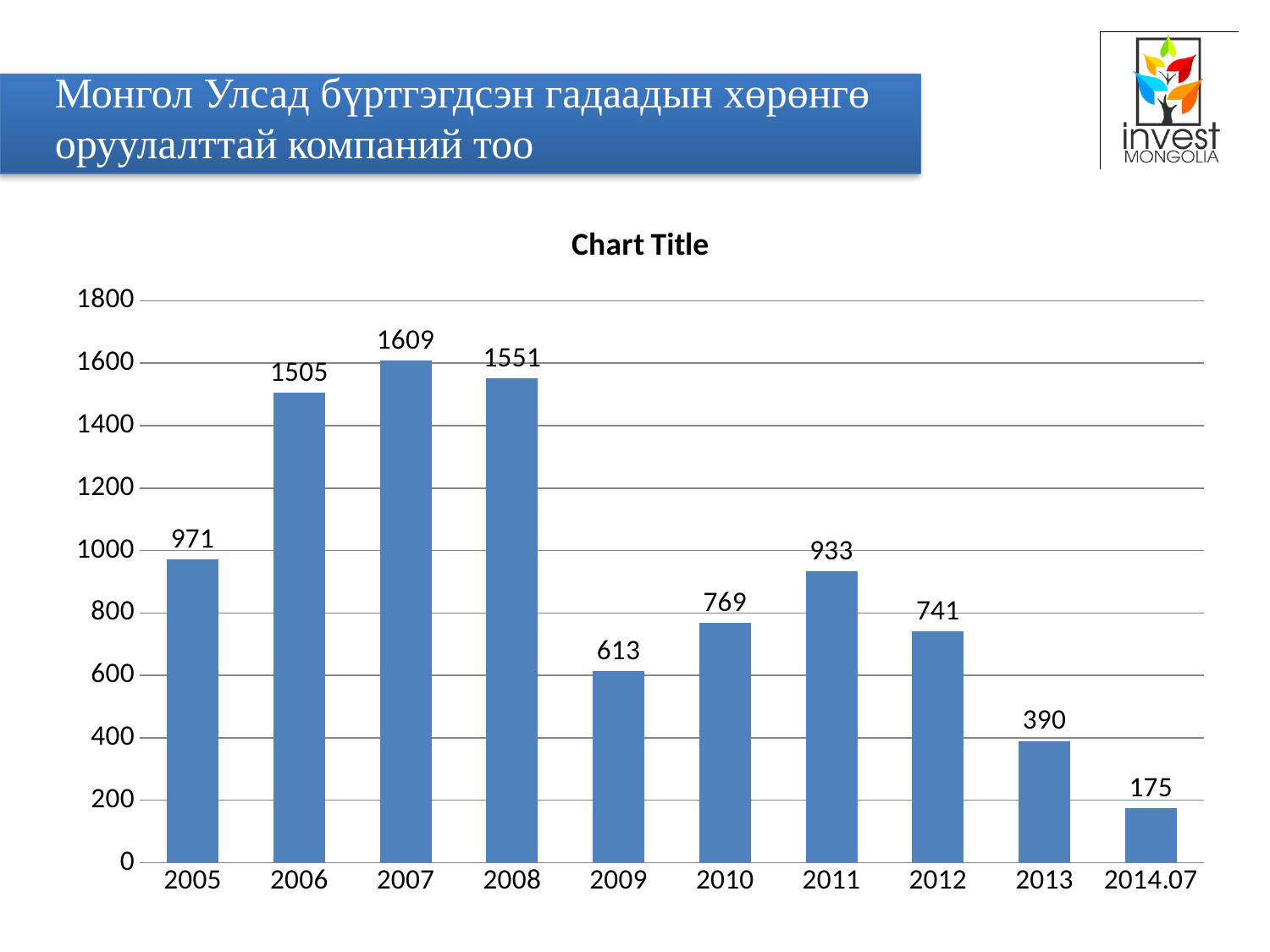
What is the value for 2011? 933 Which is larger, the value for 2010 or the value for 2012? 2010 What is the title printed above the chart? Chart Title Which year has the highest value? 2007 What kind of chart is shown on the slide? bar chart How many categories are shown on the x axis? 10 What is the difference between the values for 2008 and 2009? 938 What is the value for 2014.07? 175 Which category has the lowest value? 2014.07 Do the values rise or fall from 2011 to 2014.07? fall What is the value for 2007? 1609 Is the value for 2013 greater or less than 400? less